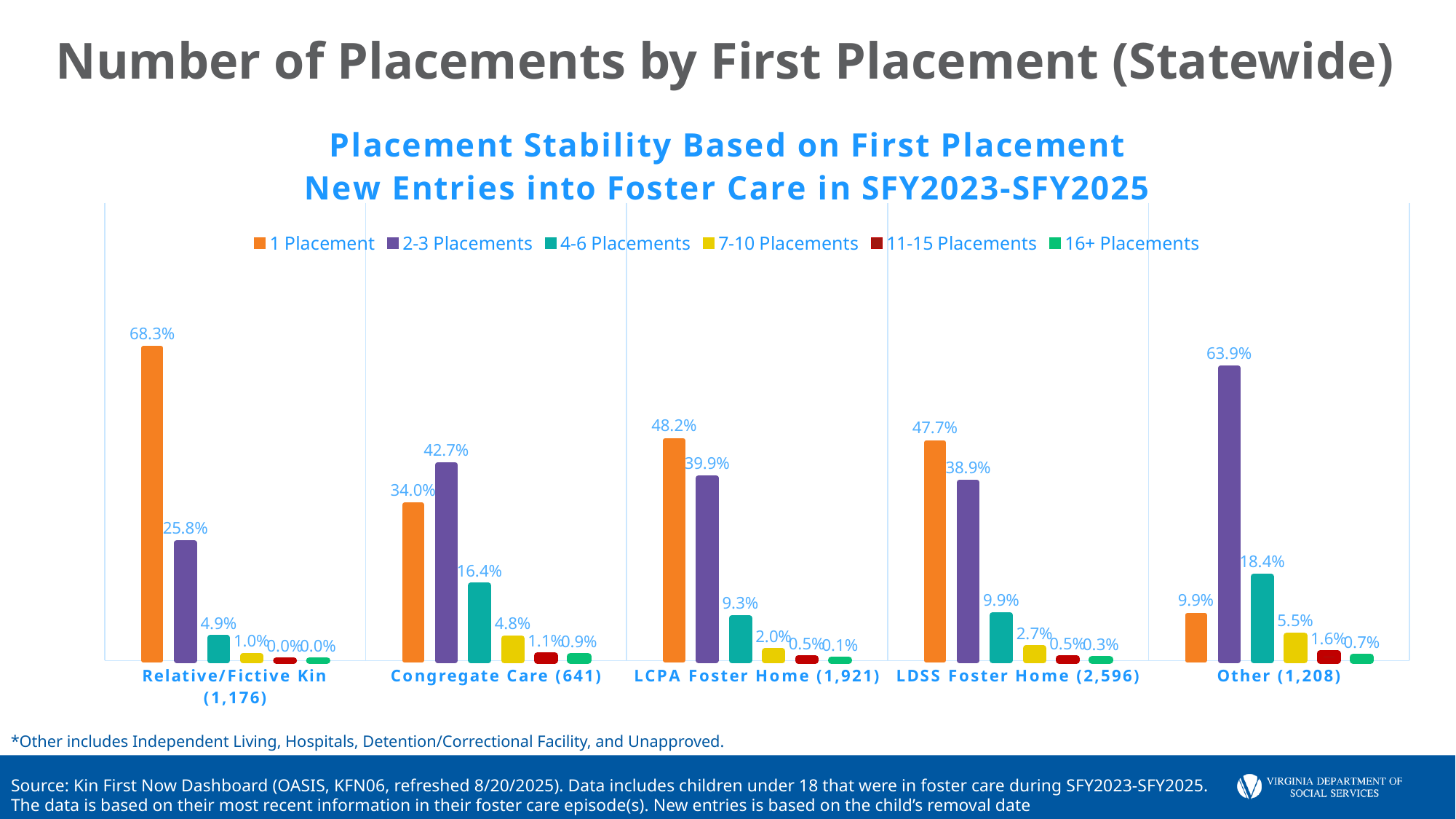
How many first placement categories are shown on the x axis? 5 Which is larger for Congregate Care (641): the 1 Placement value or the 2-3 Placements value? 2-3 Placements What type of chart is shown on the slide? Bar chart What is the value for 7-10 Placements in the LDSS Foster Home (2,596) category? 2.7% What is the difference between the 1 Placement and 2-3 Placements values for LCPA Foster Home (1,921)? 8.3% What percentage of children whose first placement was Relative/Fictive Kin had 1 Placement? 68.3% Which category has the highest value for 1 Placement? Relative/Fictive Kin (1,176) Which category has the lowest value for 1 Placement? Other (1,208) What is the value for 4-6 Placements in the Congregate Care (641) category? 16.4% Which series is shown in orange in the legend? 1 Placement How many series does the legend list? 6 What is the value for 2-3 Placements in the Other (1,208) category? 63.9%